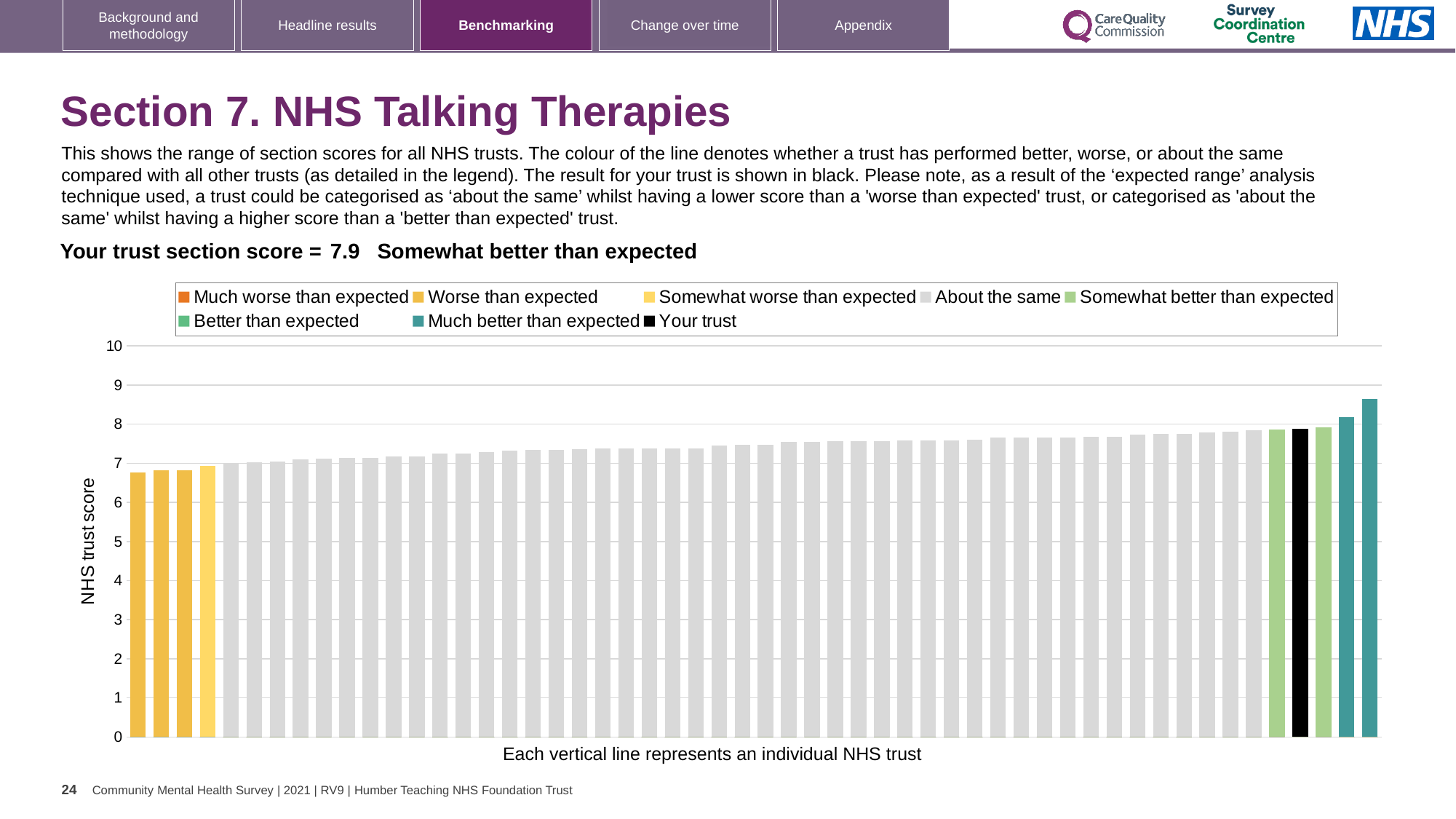
What is the label on the vertical axis of the chart? NHS trust score What is the highest value shown on the vertical axis? 10 Is the value of the black 'Your trust' bar greater or less than 7? greater Is the value of the rightmost (highest) bar greater or less than 8? greater What colour is used for the 'Your trust' bar according to the legend? black Which bar is higher: the black 'Your trust' bar or the rightmost teal bar? the rightmost teal bar How many entries does the chart legend list? 8 Is the value of the lowest bar greater or less than 6? greater What is the section score for your trust shown on the slide? 7.9 What kind of chart is shown on the slide? bar chart Do the bar values rise or fall from left to right across the chart? rise